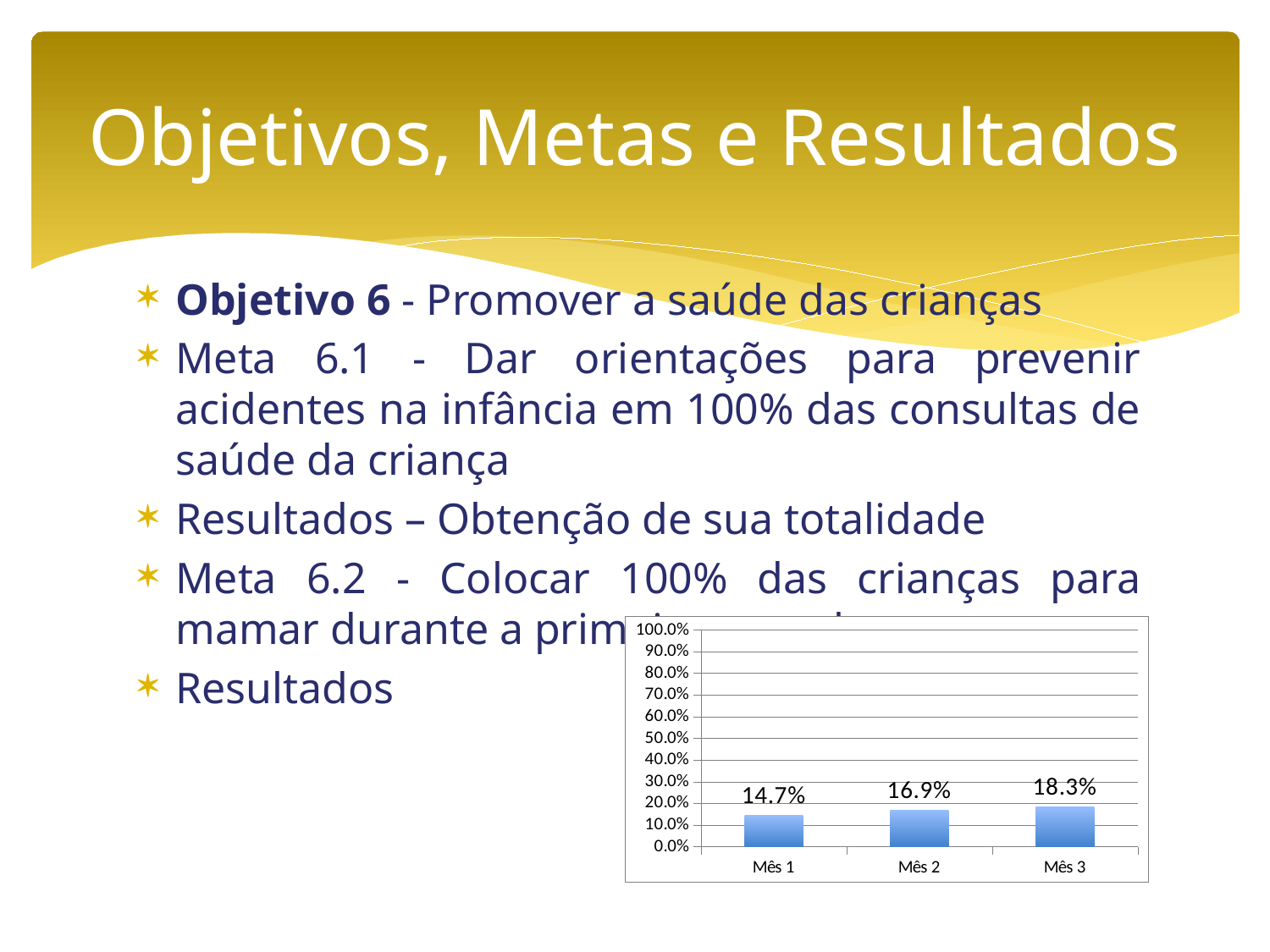
What is the value for Mês 1? 14.7% Which month has the highest value? Mês 3 What is the value for Mês 2? 16.9% What is the difference between the values for Mês 2 and Mês 1? 2.2% How many categories are shown on the x axis of the chart? 3 What kind of chart is shown on the slide? bar chart What is the value for Mês 3? 18.3% Do the values rise or fall from Mês 1 to Mês 3? rise Which is larger, the value for Mês 2 or the value for Mês 3? Mês 3 Is the value for Mês 3 greater or less than 20.0%? less What is the difference between the values for Mês 3 and Mês 1? 3.6% Which month has the lowest value? Mês 1